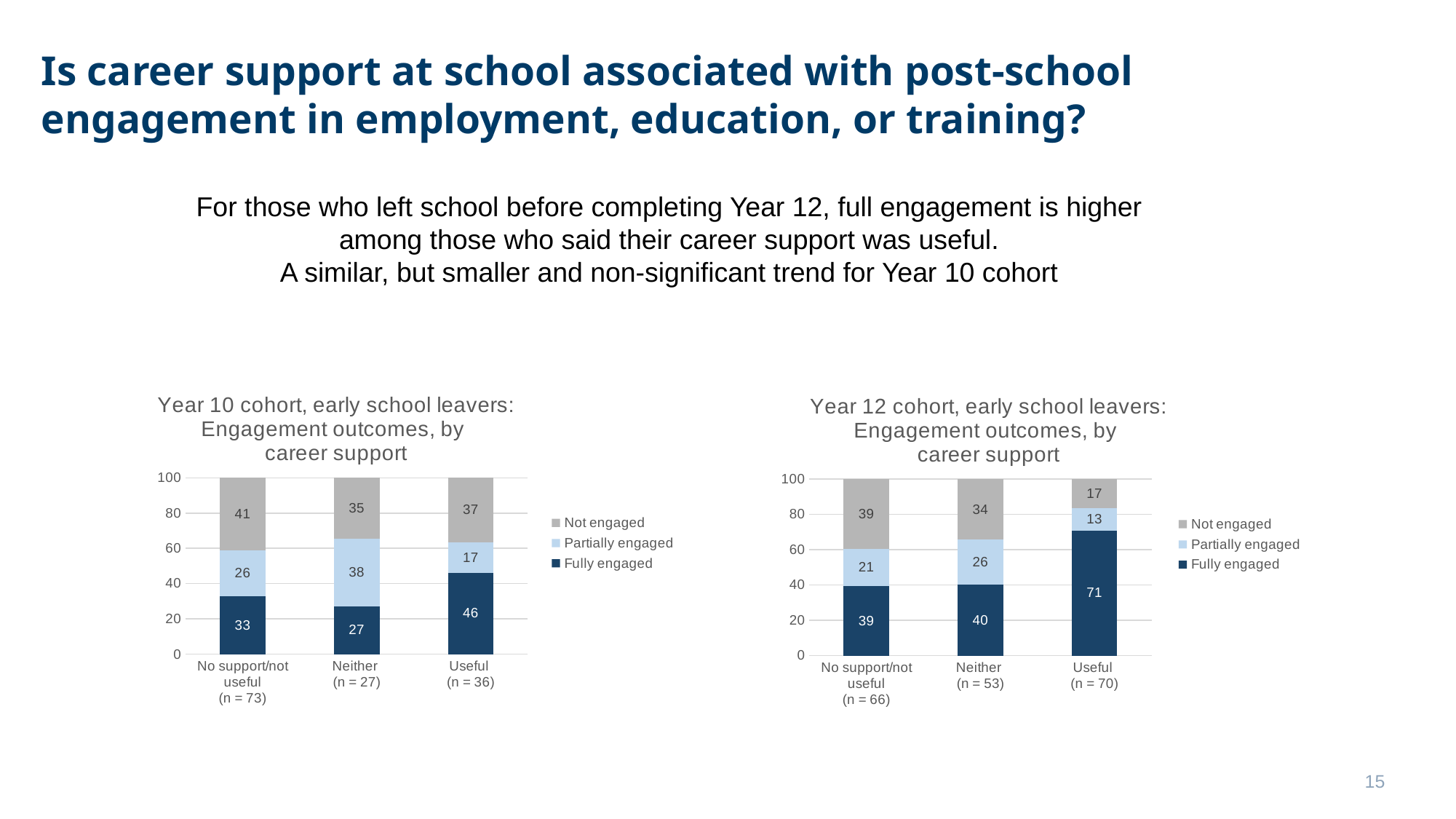
In the Year 10 cohort chart, what is the Fully engaged value for Useful (n = 36)? 46 In the Year 12 cohort chart, what is the difference between the Fully engaged values for Useful (n = 70) and Neither (n = 53)? 31 How many career support categories are shown in the Year 10 cohort chart? 3 What kind of chart is the Year 12 cohort chart? Stacked bar chart In the Year 12 cohort chart, what is the Not engaged value for No support/not useful (n = 66)? 39 In the Year 10 cohort chart, which career support category has the lowest Fully engaged value? Neither (n = 27) In the Year 12 cohort chart, what is the Partially engaged value for Neither (n = 53)? 26 In the Year 10 cohort chart, what is the total of the stacked bar for No support/not useful (n = 73)? 100 In the Year 10 cohort chart, which is larger: the Partially engaged value for Neither (n = 27) or for Useful (n = 36)? Neither (n = 27) In the Year 12 cohort chart, which colour represents the Not engaged series? Grey In the Year 12 cohort chart, which career support category has the highest Fully engaged value? Useful (n = 70) How many series does the legend of the Year 12 cohort chart list? 3